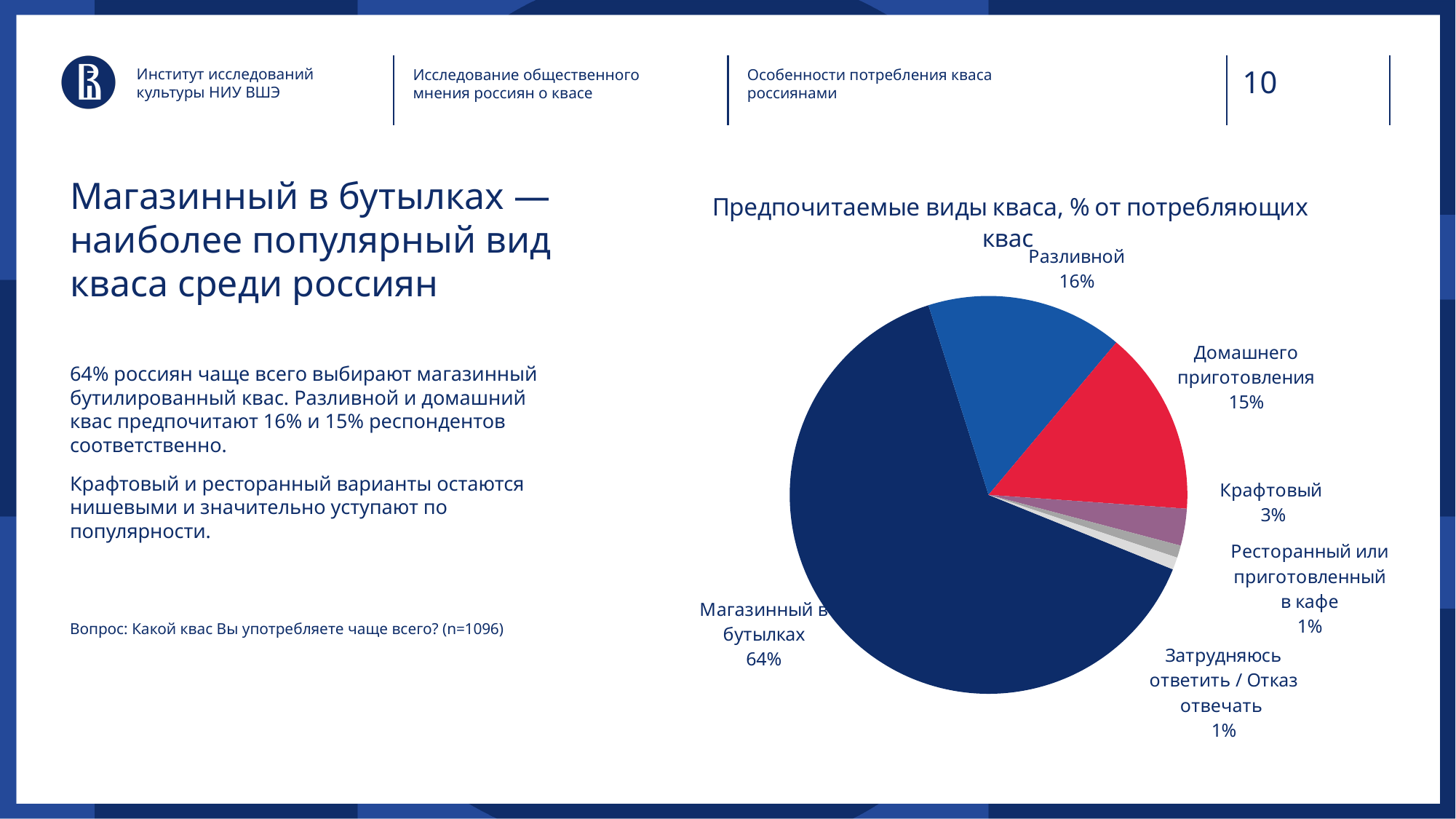
How many categories are shown in the pie chart? 6 What is the value for "Крафтовый"? 3% What is the difference between the shares of "Разливной" and "Крафтовый"? 13% Which is larger, the share for "Домашнего приготовления" or the share for "Крафтовый"? Домашнего приготовления What share of the pie does "Магазинный в бутылках" hold? 64% Which category has the largest share of the pie? Магазинный в бутылках What is the value for "Домашнего приготовления"? 15% What kind of chart is shown on the slide? Pie chart What is the value for "Разливной"? 16% What is the value for "Ресторанный или приготовленный в кафе"? 1% What is the title of the chart? Предпочитаемые виды кваса, % от потребляющих квас What is the difference between the shares of "Магазинный в бутылках" and "Разливной"? 48%